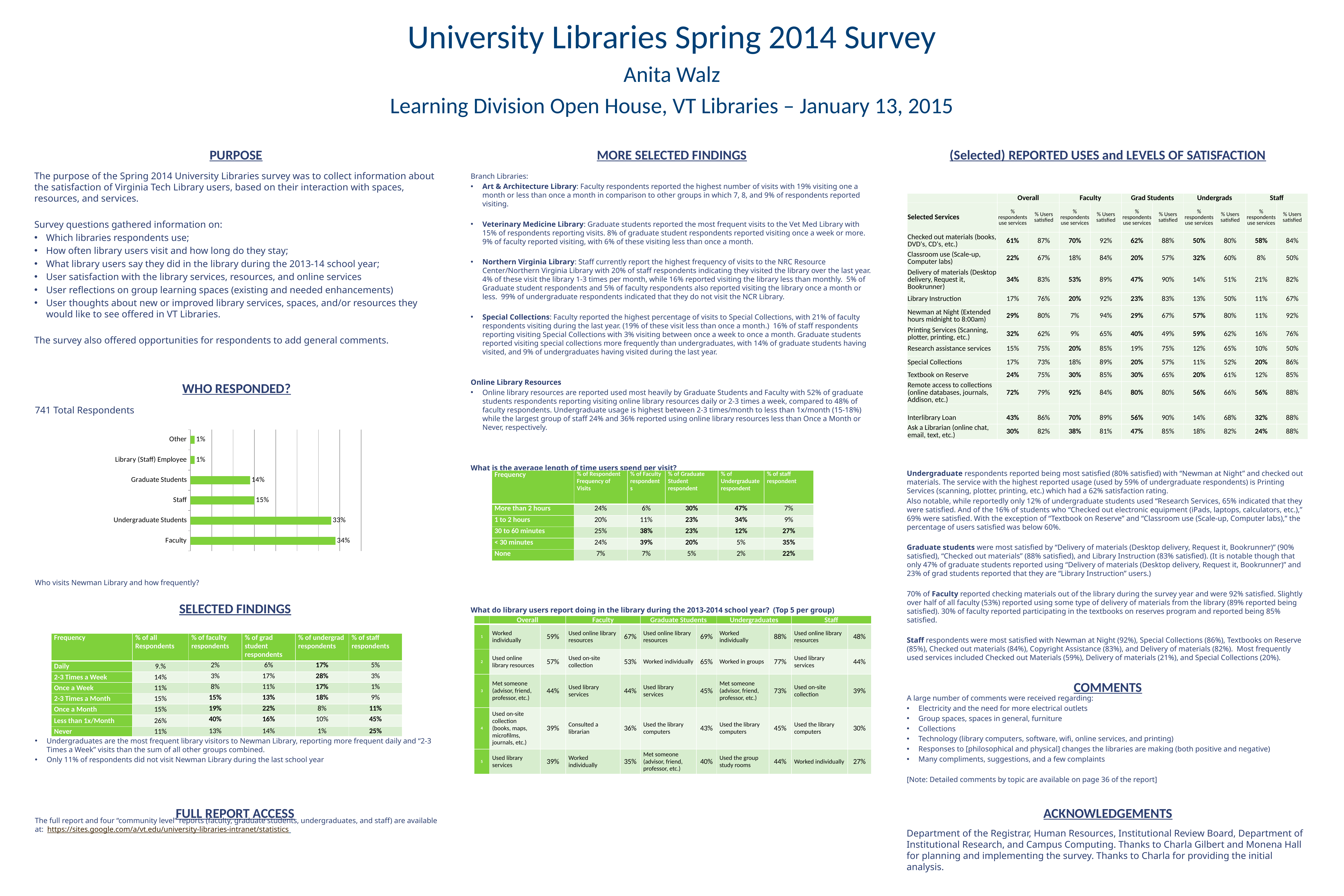
In the "WHO RESPONDED?" bar chart, what percentage of respondents were Undergraduate Students? 33% In the "WHO RESPONDED?" bar chart, what is the difference in percentage points between Undergraduate Students and Staff? 18 In the "WHO RESPONDED?" bar chart, what percentage of respondents were Graduate Students? 14% In the "WHO RESPONDED?" bar chart, how many respondent categories are shown? 6 In the "WHO RESPONDED?" bar chart, what percentage of respondents were Faculty? 34% In the "WHO RESPONDED?" bar chart, which respondent group has the highest percentage? Faculty What kind of chart is shown under "WHO RESPONDED?"? bar chart What colour are the bars in the "WHO RESPONDED?" bar chart? green In the "WHO RESPONDED?" bar chart, what percentage of respondents were Staff? 15% In the "WHO RESPONDED?" bar chart, what is the difference in percentage points between Faculty and Graduate Students? 20 In the "WHO RESPONDED?" bar chart, which is larger, the percentage for Staff or for Graduate Students? Staff In the "WHO RESPONDED?" bar chart, what percentage of respondents were Library (Staff) Employee? 1%